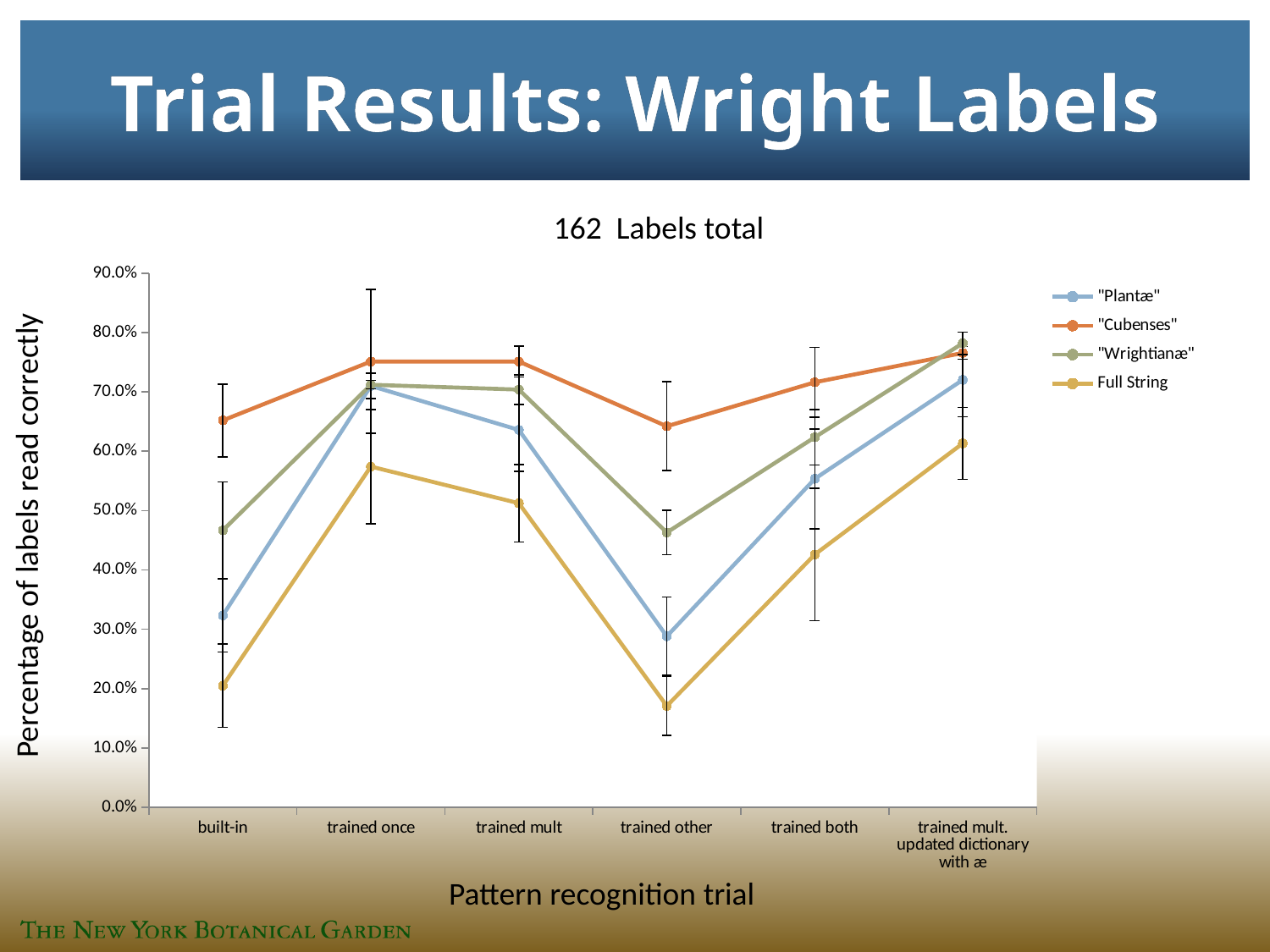
How many pattern recognition trials are shown along the x axis? 6 At trained other, which is larger: the value for "Plantæ" or the value for "Wrightianæ"? "Wrightianæ" Is the value for "Cubenses" at trained once greater or less than 70.0%? greater At which trial does the Full String series reach its lowest value? trained other Is the value for "Plantæ" at trained both greater or less than 50.0%? greater Is the value for Full String at built-in greater or less than 30.0%? less Which series has the lowest value at trained other? Full String Does the Full String series rise or fall from trained other to trained mult. updated dictionary with æ? rise Which series has the highest value at built-in? "Cubenses" How many series does the legend list? 4 What kind of chart is shown on the slide? line chart What is the title of the chart? 162 Labels total